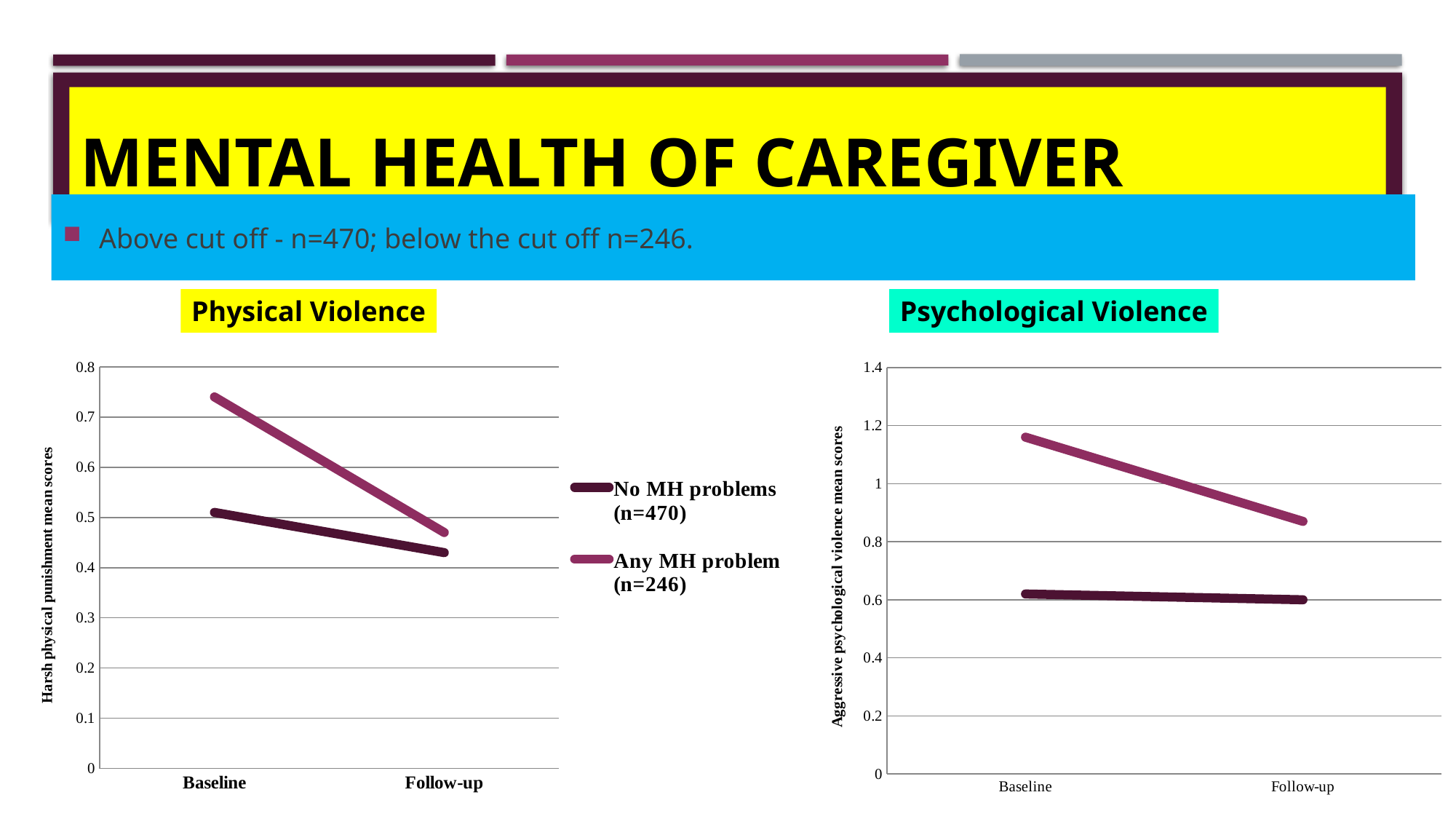
In the Physical Violence chart, which group has the higher Baseline score: No MH problems (n=470) or Any MH problem (n=246)? Any MH problem (n=246) In the Psychological Violence chart, is the Follow-up value for Any MH problem (n=246) greater or less than 1? less How many time points are shown on the x axis of the Psychological Violence chart? 2 In the Physical Violence chart, is the Baseline value for Any MH problem (n=246) greater or less than 0.7? greater In the Psychological Violence chart, which group has the higher Follow-up score: No MH problems (n=470) or Any MH problem (n=246)? Any MH problem (n=246) How many series does the legend list for the Physical Violence chart? 2 In the Physical Violence chart, does the Any MH problem (n=246) line rise or fall from Baseline to Follow-up? fall In the Physical Violence chart, is the Follow-up value for No MH problems (n=470) greater or less than 0.5? less What kind of chart is the Physical Violence chart? line chart What is the y-axis title of the Psychological Violence chart? Aggressive psychological violence mean scores